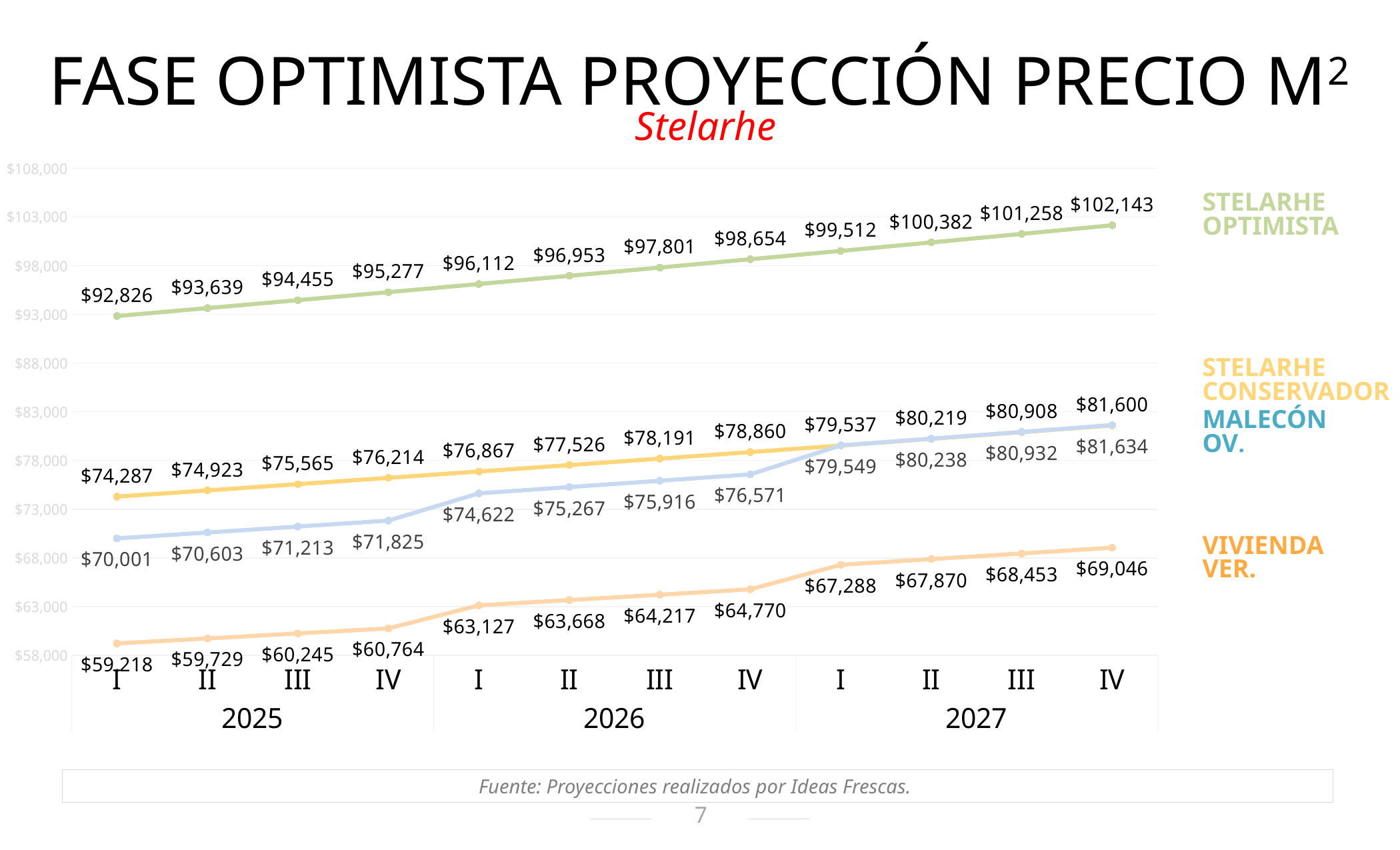
What is the value of the Vivienda Ver. series in quarter I of 2025? $59,218 In quarter I of 2026, which is larger: the Malecón OV. value or the Vivienda Ver. value? Malecón OV. What is the value of the Stelarhe Optimista series in quarter IV of 2027? $102,143 By how much does the Stelarhe Optimista value in quarter IV of 2027 exceed its value in quarter I of 2025? $9,317 What is the value of the Malecón OV. series in quarter II of 2026? $75,267 Is the Stelarhe Optimista value in quarter I of 2025 greater or less than $93,000? less Which series has the highest value in quarter IV of 2027? Stelarhe Optimista How many series are plotted on the chart? 4 How many quarterly data points does each series have? 12 What kind of chart is shown on the slide? Line chart What is the value of the Stelarhe Conservador series in quarter III of 2027? $80,908 Which series has the lowest value in quarter I of 2025? Vivienda Ver.